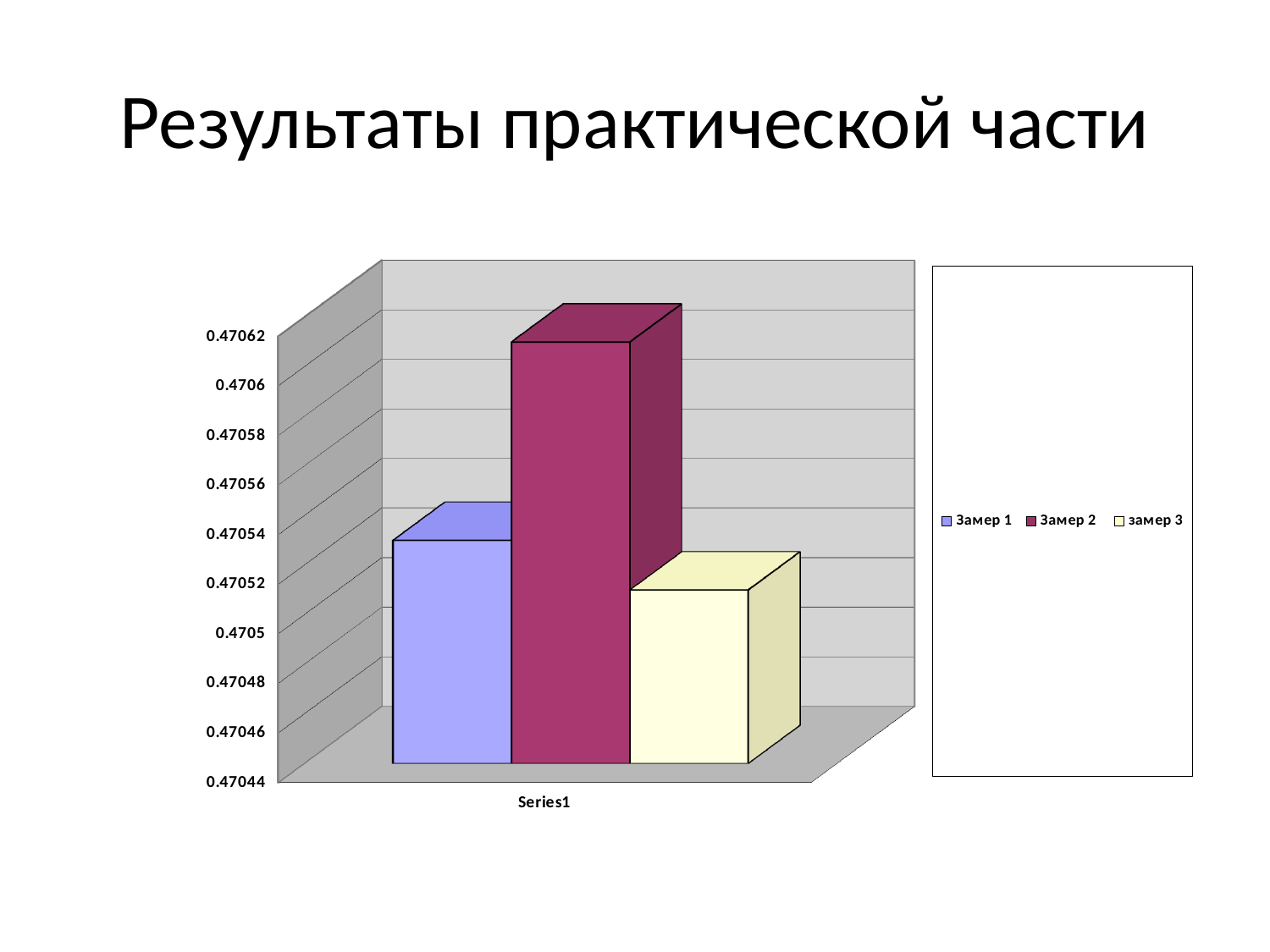
What is the label shown on the x axis of the chart? Series1 What is the title of the slide? Результаты практической части Is the value for Замер 2 greater or less than 0.4706? greater What kind of chart is shown on the slide? bar chart Which is larger, the value for Замер 2 or the value for Замер 1? Замер 2 Is the value for замер 3 greater or less than 0.4705? greater Which is larger, the value for Замер 1 or the value for замер 3? Замер 1 How many series does the legend list? 3 Which series has the highest bar? Замер 2 Which series has the lowest bar? замер 3 Is the value for Замер 1 greater or less than 0.4706? less How many categories are shown on the x axis? 1